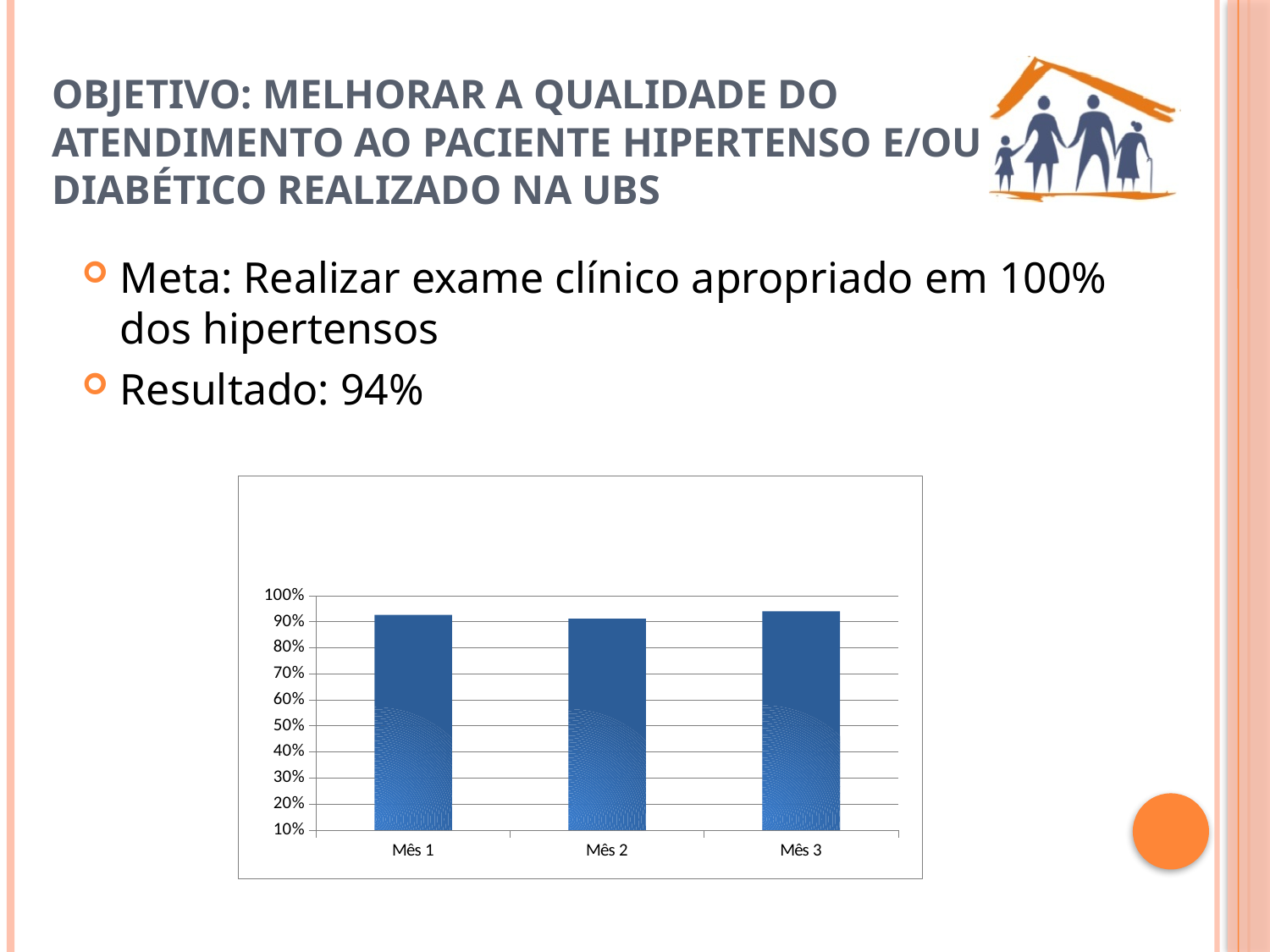
Is the value for Mês 2 greater or less than 80%? greater How many categories (bars) does the chart show? 3 What kind of chart is shown on the slide? bar chart Is the value for Mês 2 greater or less than 100%? less Is the value for Mês 3 greater or less than 100%? less What is the label of the first category on the x axis? Mês 1 Which is larger, the value for Mês 3 or the value for Mês 2? Mês 3 What is the highest tick value shown on the y axis? 100%